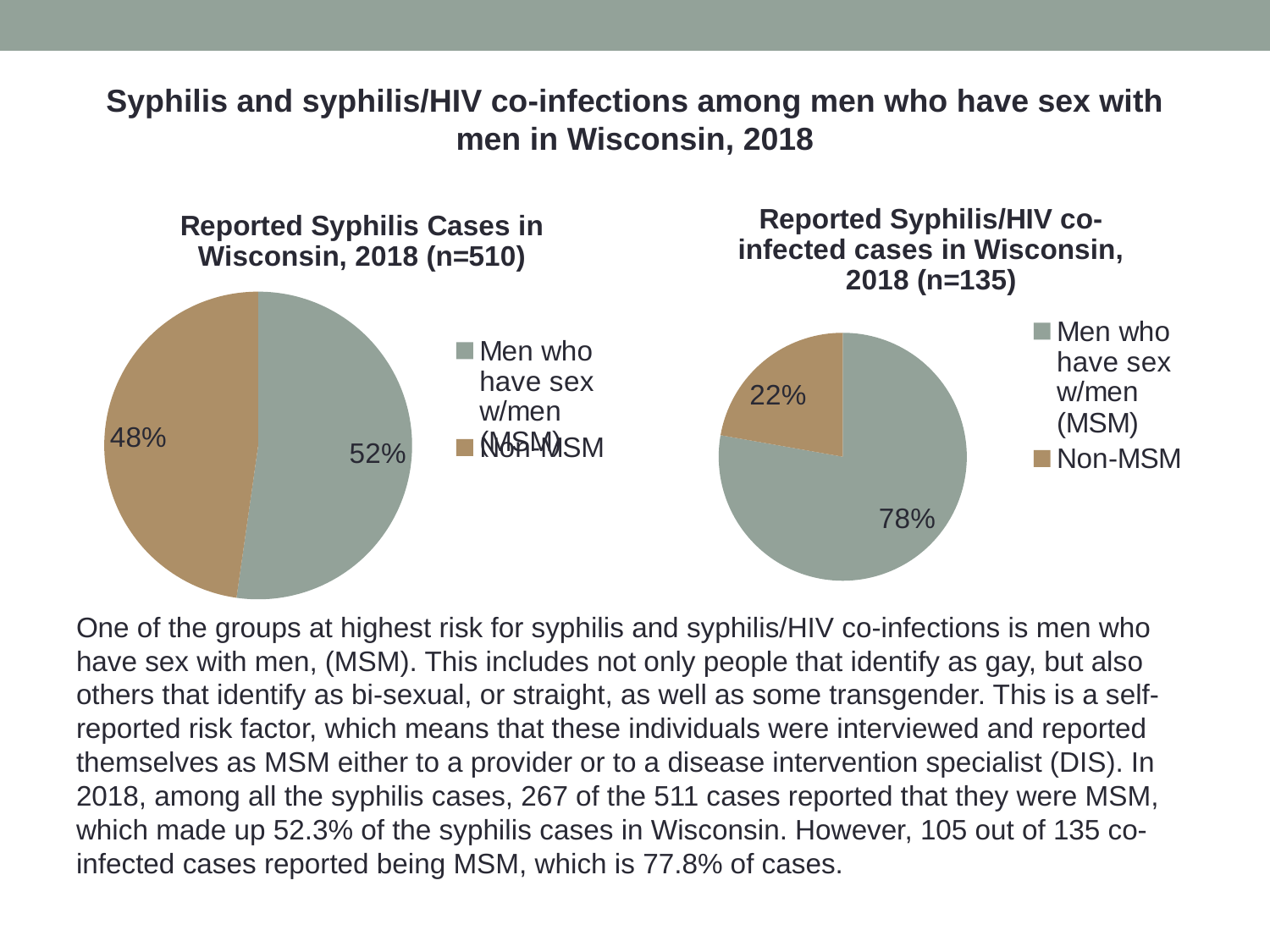
What type of chart is used for the reported syphilis cases in Wisconsin, 2018? Pie chart In the right-hand chart on syphilis/HIV co-infected cases, what is the difference in percentage points between the MSM slice and the Non-MSM slice? 56 In the chart titled "Reported Syphilis Cases in Wisconsin, 2018 (n=510)", what share of cases is labelled for men who have sex with men (MSM)? 52% In the chart titled "Reported Syphilis/HIV co-infected cases in Wisconsin, 2018 (n=135)", what share of cases is labelled Non-MSM? 22% In the chart titled "Reported Syphilis/HIV co-infected cases in Wisconsin, 2018 (n=135)", what share of cases is labelled for men who have sex with men (MSM)? 78% How many charts are shown on the slide? 2 In the left-hand chart on reported syphilis cases, what is the difference in percentage points between the MSM slice and the Non-MSM slice? 4 How many slices does the chart titled "Reported Syphilis/HIV co-infected cases in Wisconsin, 2018 (n=135)" have? 2 In the right-hand chart on syphilis/HIV co-infected cases, which group has the larger slice? Men who have sex w/men (MSM) In the right-hand chart on syphilis/HIV co-infected cases, which group has the smaller slice? Non-MSM In the chart titled "Reported Syphilis Cases in Wisconsin, 2018 (n=510)", what share of cases is labelled Non-MSM? 48% Is the MSM share larger in the left-hand chart (reported syphilis cases) or in the right-hand chart (syphilis/HIV co-infected cases)? Right-hand chart (syphilis/HIV co-infected cases)